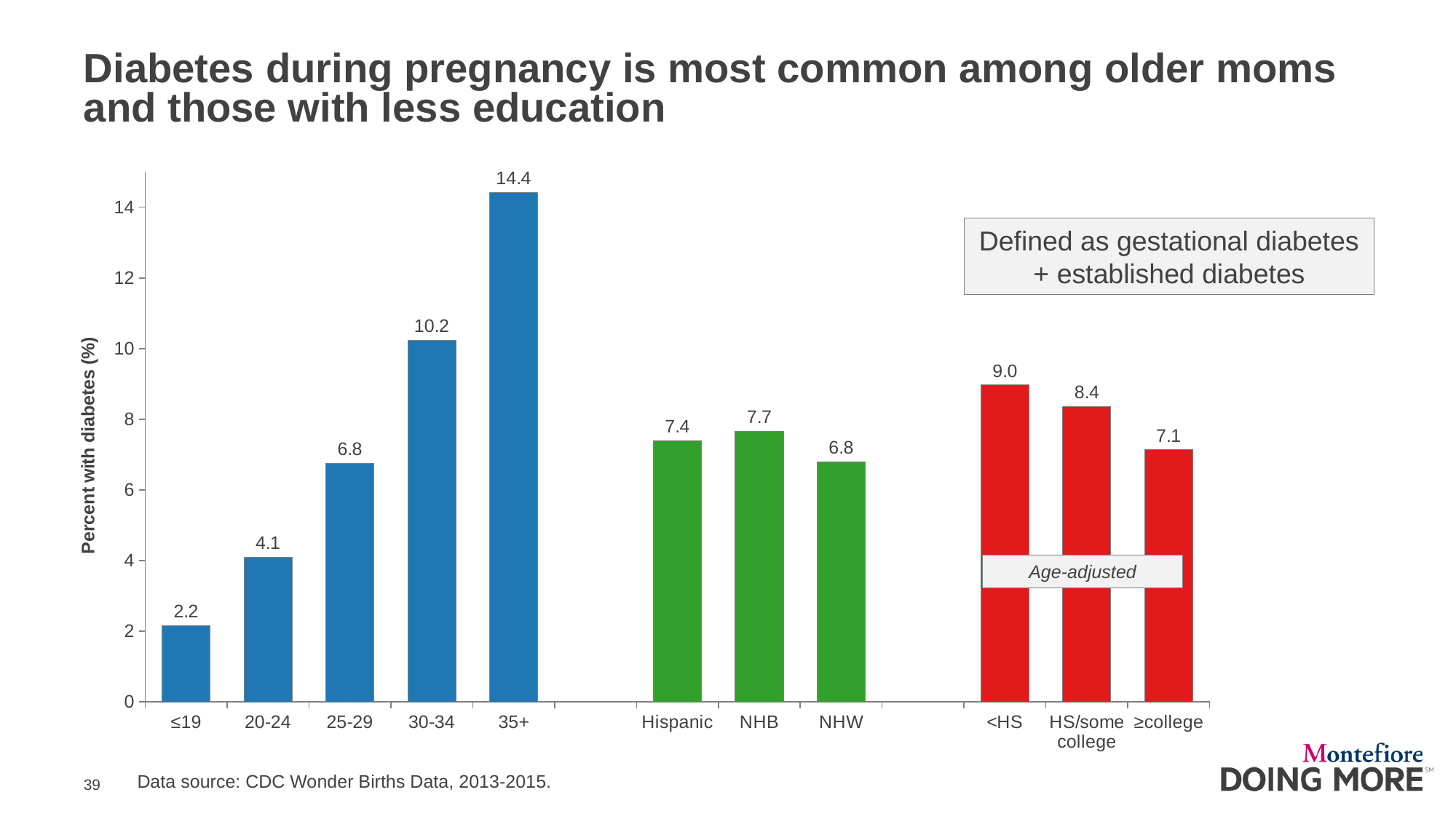
What is the percent with diabetes for mothers aged 35+? 14.4 Which category has the highest percent with diabetes? 35+ What is the difference in percent with diabetes between <HS and ≥college? 1.9 What is the percent with diabetes for Hispanic mothers? 7.4 Do the values rise or fall across the age groups from ≤19 to 35+? Rise What kind of chart is shown on the slide? Bar chart Is the value for the 30-34 age group greater or less than 10? greater What is the difference in percent with diabetes between the 35+ and 30-34 age groups? 4.2 How many bars are plotted on the chart? 11 What is the percent with diabetes for mothers with less than a high school education (<HS)? 9.0 Which has a higher percent with diabetes, NHB or NHW? NHB Which category has the lowest percent with diabetes? ≤19